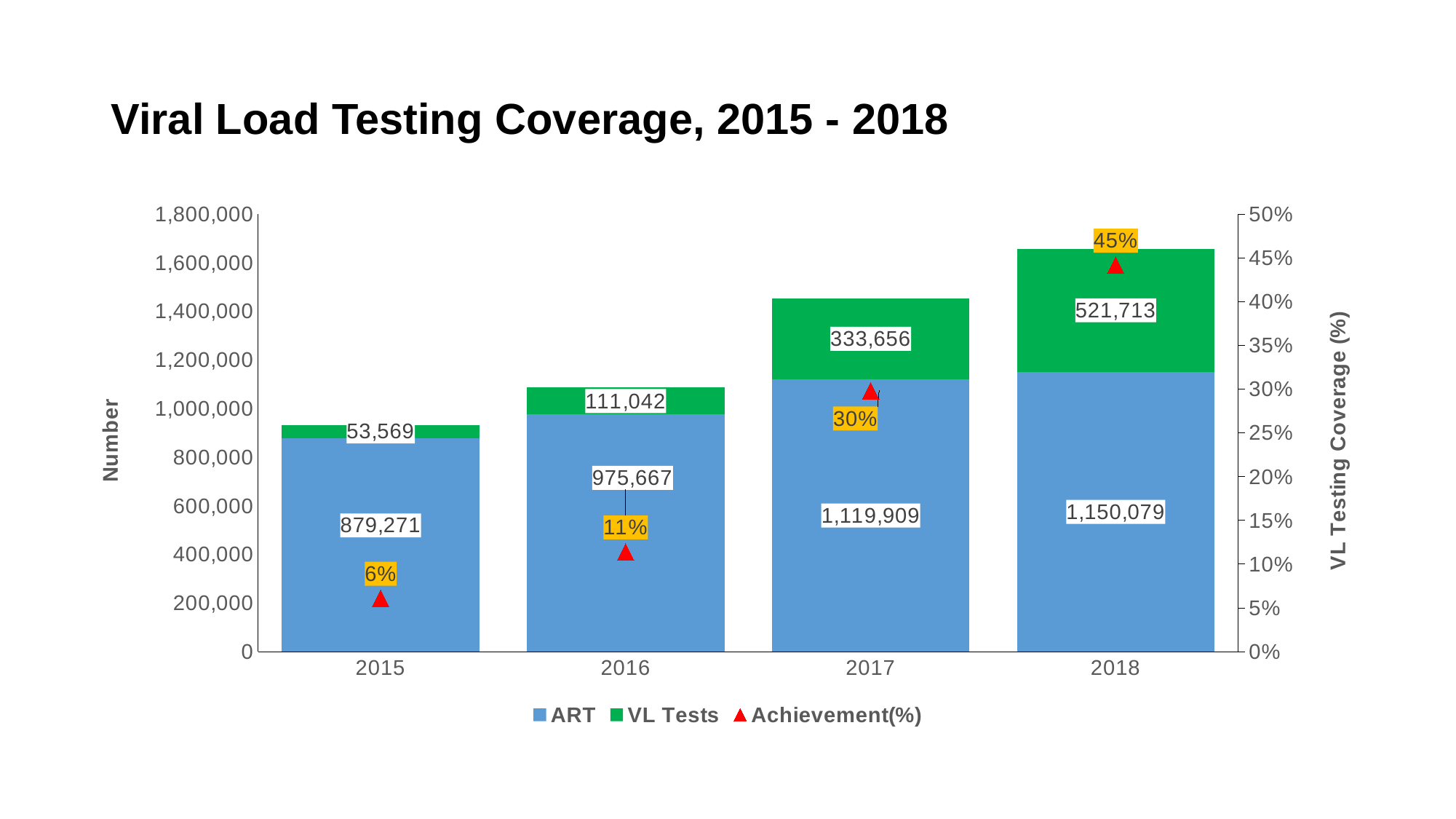
What is the difference between the VL Tests values for 2018 and 2017? 188,057 How many years are shown on the x axis? 4 How many series does the legend list? 3 Which is larger, the ART value for 2016 or the ART value for 2015? 2016 Which year has the lowest Achievement(%) value? 2015 What is the Achievement(%) value for 2018? 45% What is the total of the stacked bar for 2015 (ART plus VL Tests)? 932,840 What kind of chart is this? Stacked bar chart with a line/marker series What is the ART value for 2017? 1,119,909 Which year has the highest VL Tests value? 2018 Do the Achievement(%) values rise or fall from 2015 to 2018? Rise What is the VL Tests value for 2016? 111,042